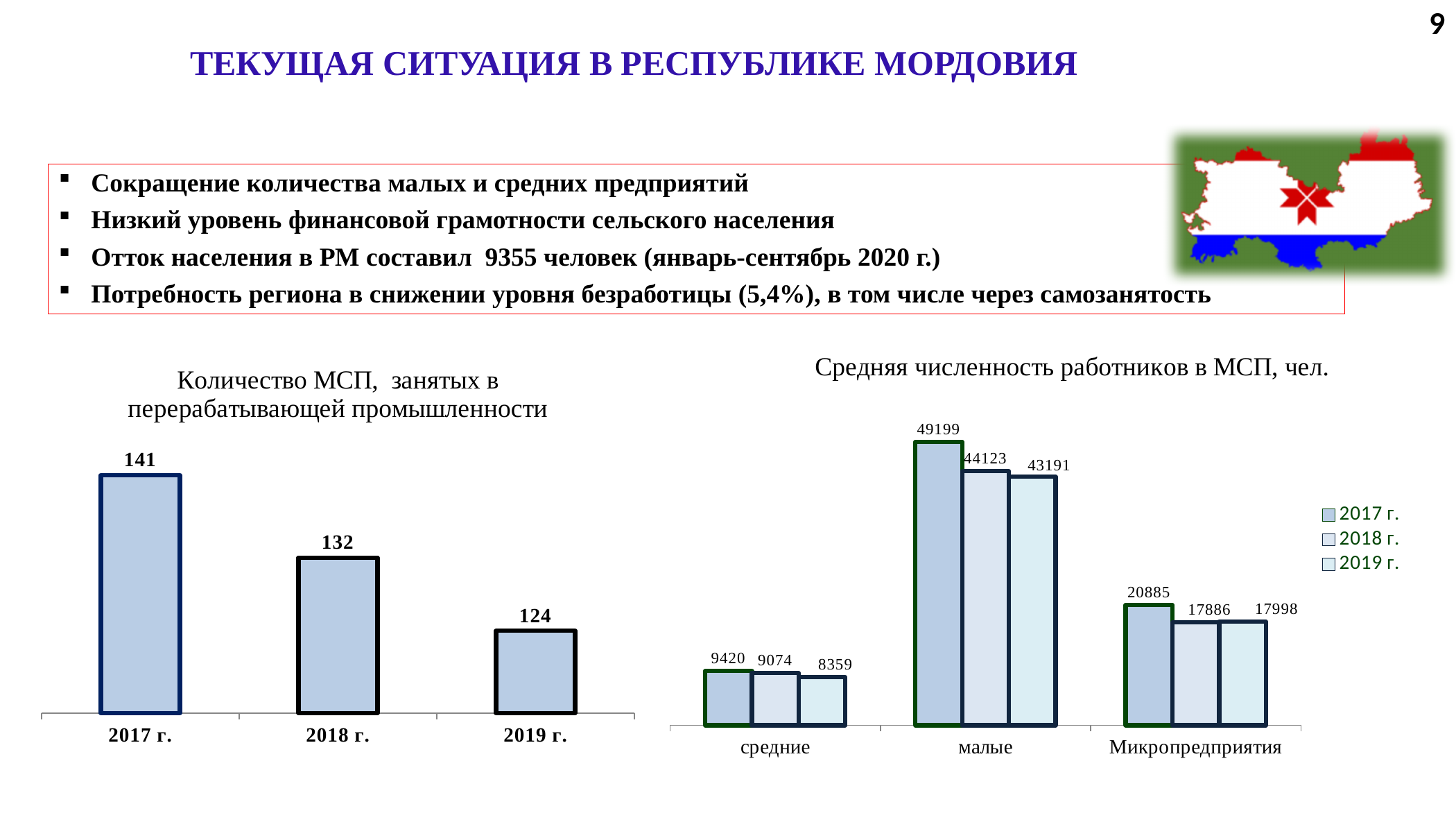
In the chart 'Средняя численность работников в МСП, чел.', which category has the lowest value in 2018 г.? средние In the chart 'Средняя численность работников в МСП, чел.', which category has the highest value in 2019 г.? малые In the chart 'Количество МСП, занятых в перерабатывающей промышленности', do the values rise or fall from 2017 г. to 2019 г.? fall In the chart 'Средняя численность работников в МСП, чел.', what is the value for Микропредприятия in 2019 г.? 17998 In the chart 'Количество МСП, занятых в перерабатывающей промышленности', what is the difference between the 2017 г. and 2019 г. values? 17 In the chart 'Количество МСП, занятых в перерабатывающей промышленности', what is the value for 2019 г.? 124 In the chart 'Количество МСП, занятых в перерабатывающей промышленности', what is the value for 2017 г.? 141 In the chart 'Средняя численность работников в МСП, чел.', what is the value for малые in 2017 г.? 49199 In the chart 'Количество МСП, занятых в перерабатывающей промышленности', how many years are shown on the x axis? 3 In the chart 'Средняя численность работников в МСП, чел.', what is the difference between the малые values for 2017 г. and 2018 г.? 5076 In the chart 'Средняя численность работников в МСП, чел.', how many series does the legend list? 3 What kind of chart is 'Средняя численность работников в МСП, чел.'? bar chart